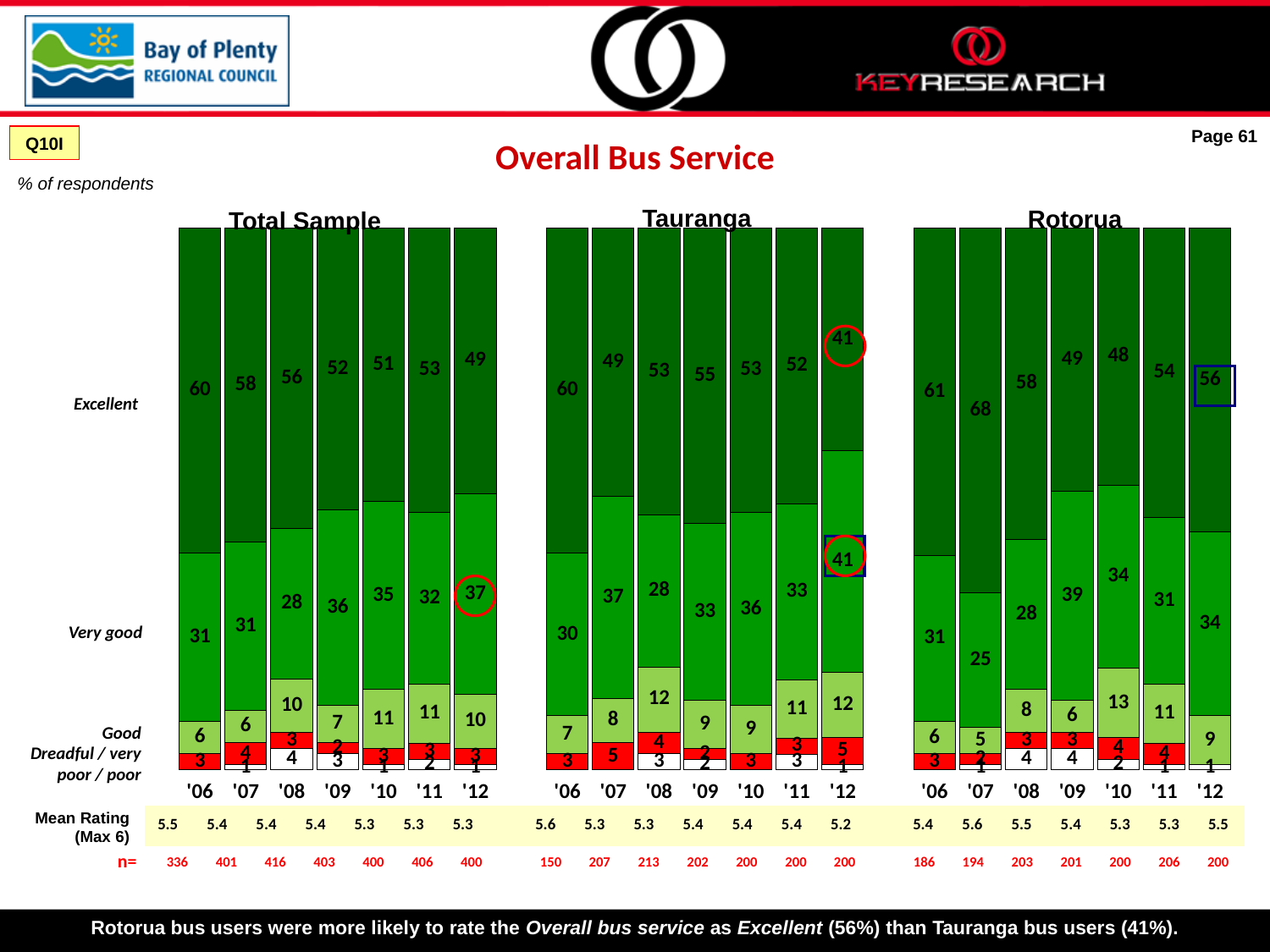
In the Tauranga chart, what percentage rated the overall bus service as Very good in '12? 41 In the Total Sample chart, what percentage of respondents rated the overall bus service as Excellent in '12? 49 In the Rotorua chart, what is the difference between the Very good percentage in '09 and in '07? 14 How many years are shown on the x axis of the Tauranga chart? 7 In the Rotorua chart, what percentage rated the overall bus service as Excellent in '07? 68 What kind of chart is used to show the Total Sample results? stacked bar chart In the Total Sample chart, does the Excellent percentage generally rise or fall from '06 to '12? fall In the Tauranga chart, which year has the lowest Excellent percentage? '12 In the Rotorua chart, which year has the highest Excellent percentage? '07 Which is larger: the Excellent percentage for Rotorua in '12 or for Tauranga in '12? Rotorua in '12 What is the Mean Rating (Max 6) shown for Tauranga in '12? 5.2 In the Total Sample chart, what is the difference between the Excellent percentage in '06 and in '12? 11